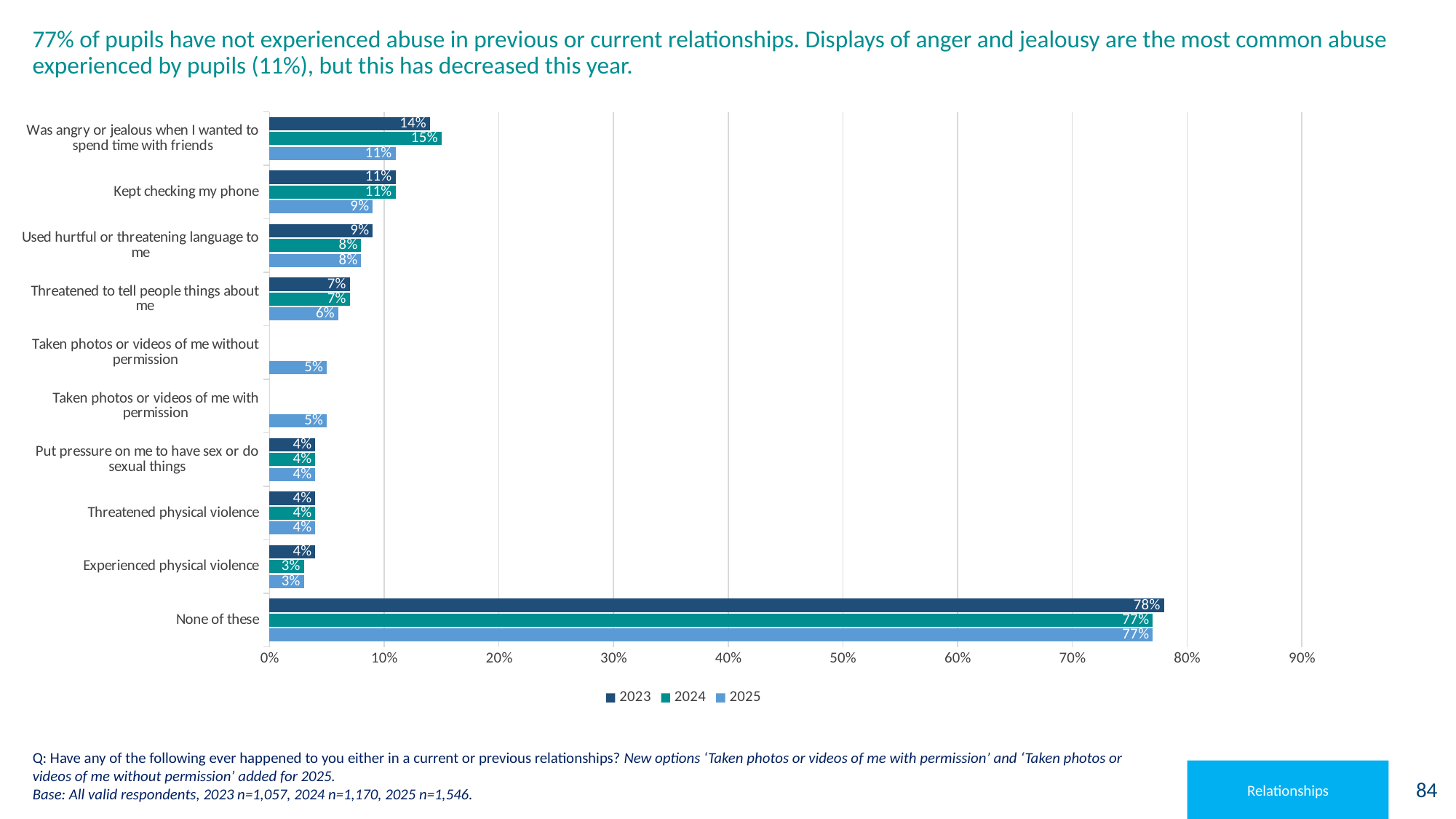
What kind of chart is shown on the slide? Bar chart Which category has the highest 2025 value? None of these How many categories are shown on the y axis of the chart? 10 Excluding 'None of these', which category has the highest 2024 value? Was angry or jealous when I wanted to spend time with friends Which is larger: the 2023 value for 'Used hurtful or threatening language to me' or the 2023 value for 'Threatened to tell people things about me'? Used hurtful or threatening language to me What is the 2025 value for 'Was angry or jealous when I wanted to spend time with friends'? 11% What is the 2024 value for 'Kept checking my phone'? 11% What is the 2025 value for 'Taken photos or videos of me without permission'? 5% Is the 2024 value for 'None of these' greater or less than 70%? greater What is the 2023 value for 'None of these'? 78% What is the difference between the 2024 and 2025 values for 'Was angry or jealous when I wanted to spend time with friends'? 4 percentage points How many series does the legend list? 3